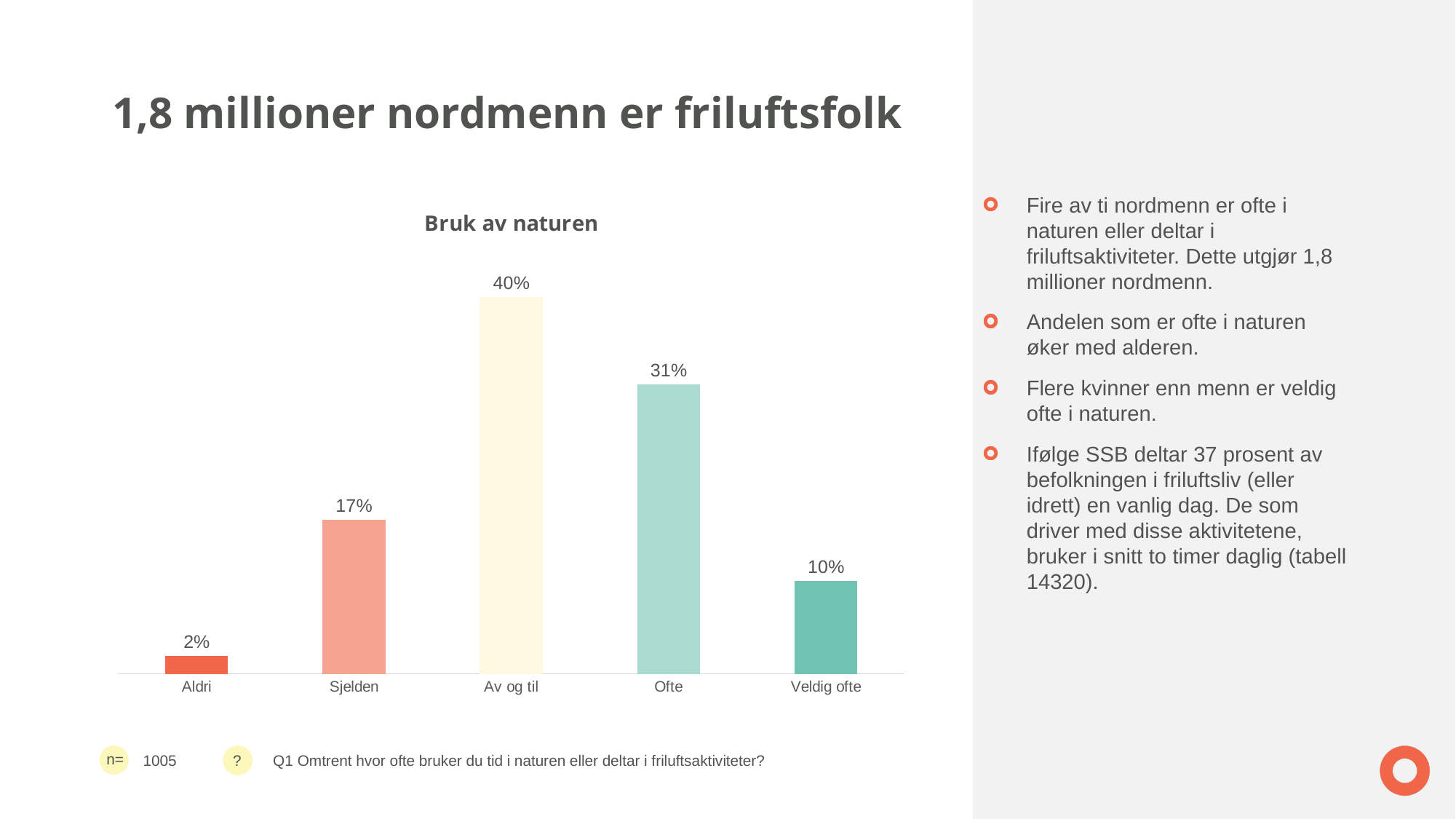
What is the value for "Veldig ofte" in the "Bruk av naturen" chart? 10% What is the value for "Sjelden" in the "Bruk av naturen" chart? 17% What kind of chart is "Bruk av naturen"? Bar chart How many categories are shown in the "Bruk av naturen" chart? 5 What is the difference between the values for "Sjelden" and "Aldri" in the "Bruk av naturen" chart? 15% What is the value for "Av og til" in the "Bruk av naturen" chart? 40% Which is larger in the "Bruk av naturen" chart, the value for "Ofte" or the value for "Veldig ofte"? Ofte What is the sample size (n) shown below the chart? 1005 Which category has the highest value in the "Bruk av naturen" chart? Av og til What is the title of the chart on the slide? Bruk av naturen Which category has the lowest value in the "Bruk av naturen" chart? Aldri What is the difference between the values for "Av og til" and "Ofte" in the "Bruk av naturen" chart? 9%